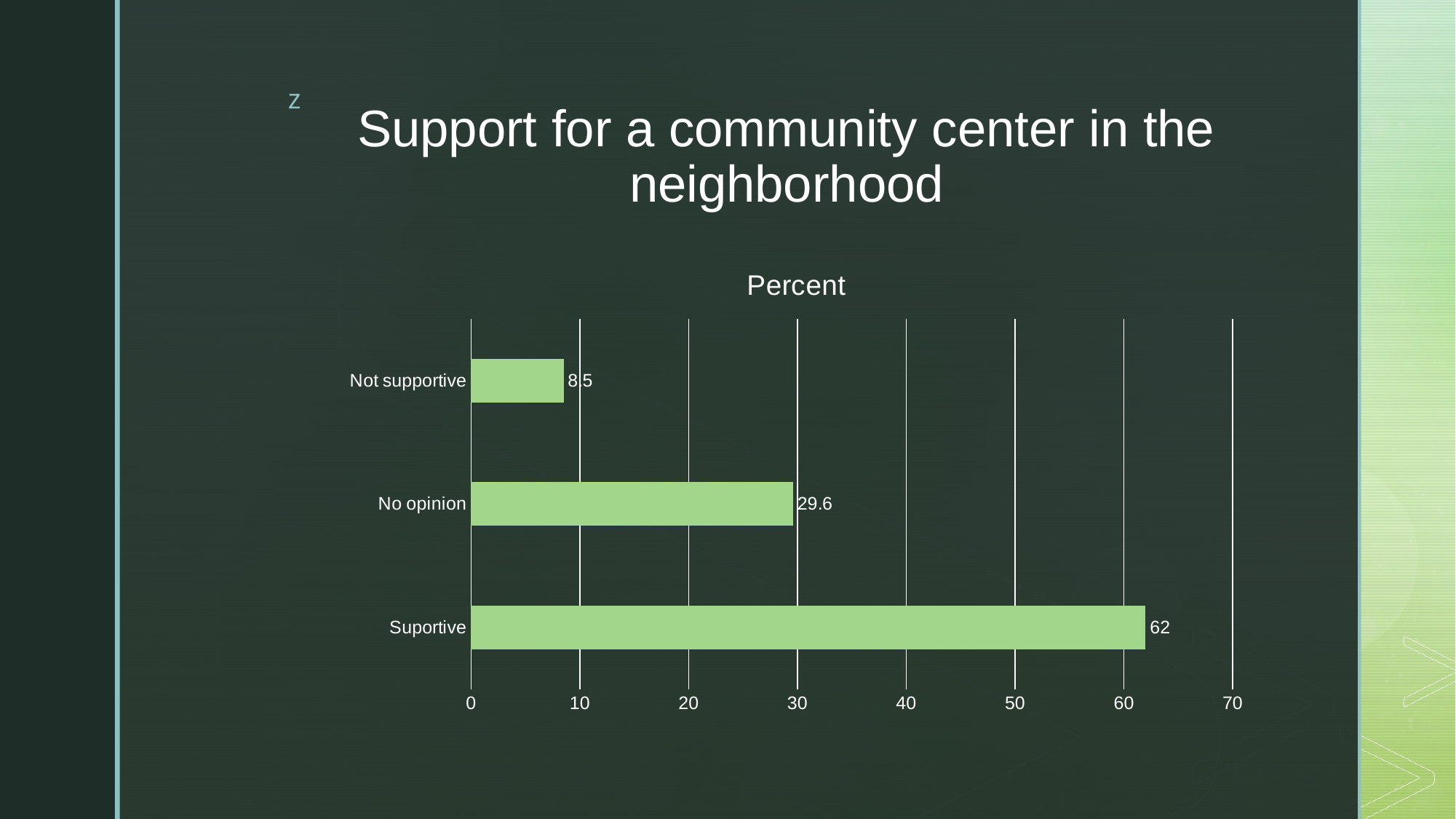
Which is larger, the value for No opinion or the value for Not supportive? No opinion Which category has the lowest value? Not supportive What kind of chart is shown on the slide? bar chart What is the value for Suportive? 62 What is the difference between the values for No opinion and Not supportive? 21.1 What is the value for Not supportive? 8.5 What is the value for No opinion? 29.6 What is the difference between the values for Suportive and No opinion? 32.4 How many categories are shown in the chart? 3 What is the title of the chart? Percent Is the value for Suportive greater or less than 50? greater Which category has the highest value? Suportive